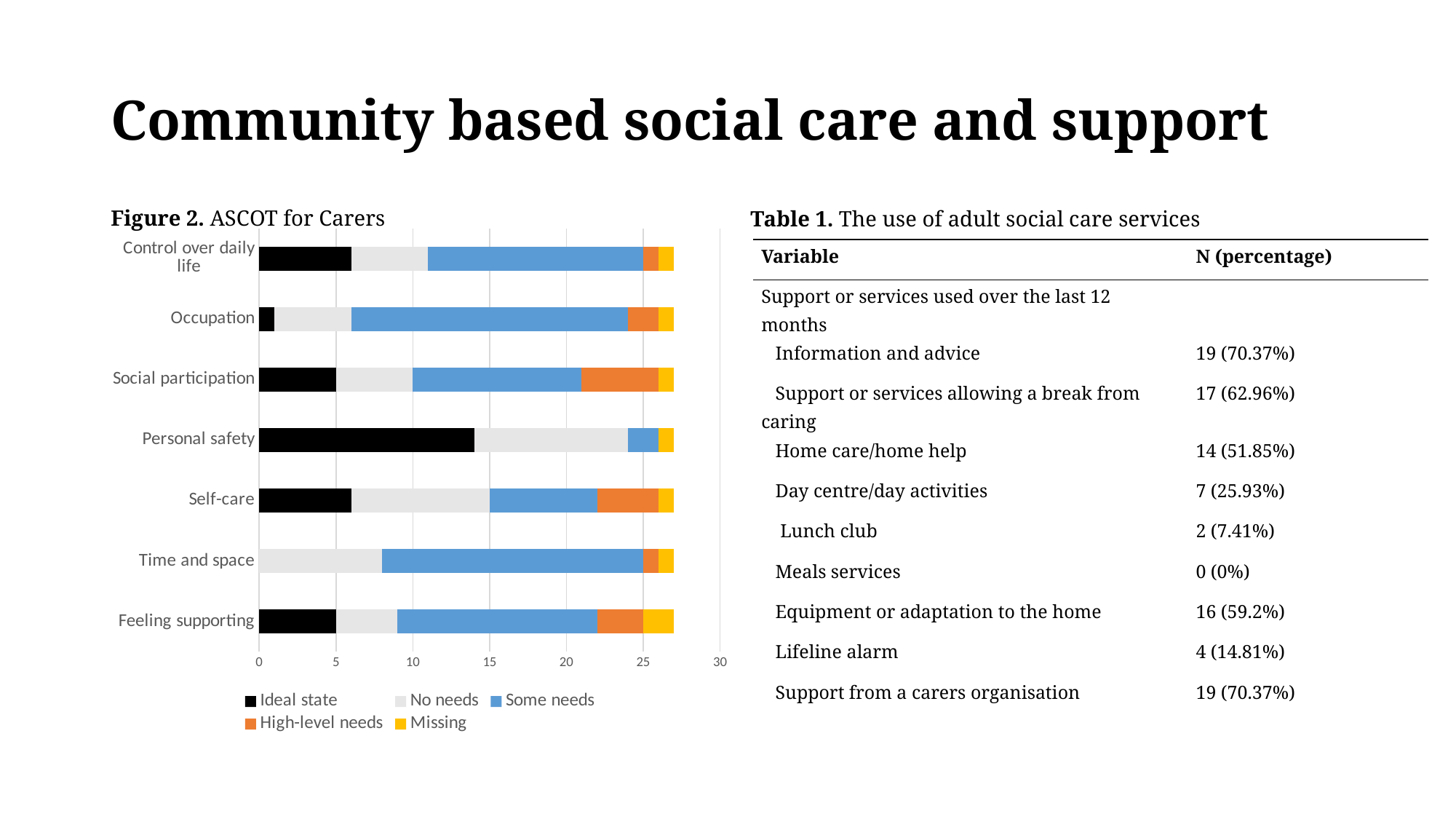
In the ASCOT for Carers chart, which category has the largest Ideal state segment? Personal safety In the ASCOT for Carers chart, which is larger: the Ideal state segment for Personal safety or for Occupation? Personal safety In the ASCOT for Carers chart, is the Ideal state value for Occupation greater or less than 5? less In the ASCOT for Carers chart, which category has the smallest Some needs segment? Personal safety In the ASCOT for Carers chart, is the Ideal state value for Personal safety greater or less than 10? greater How many series does the legend of the ASCOT for Carers chart list? 5 In the ASCOT for Carers chart, which colour represents the Missing series? Yellow What kind of chart is Figure 2, ASCOT for Carers? Stacked bar chart How many categories are shown on the y axis of the ASCOT for Carers chart? 7 In the ASCOT for Carers chart, which category has no Ideal state segment at all? Time and space In the ASCOT for Carers chart, which category has the largest High-level needs segment? Social participation In the ASCOT for Carers chart, is the Some needs value for Occupation greater or less than 15? greater